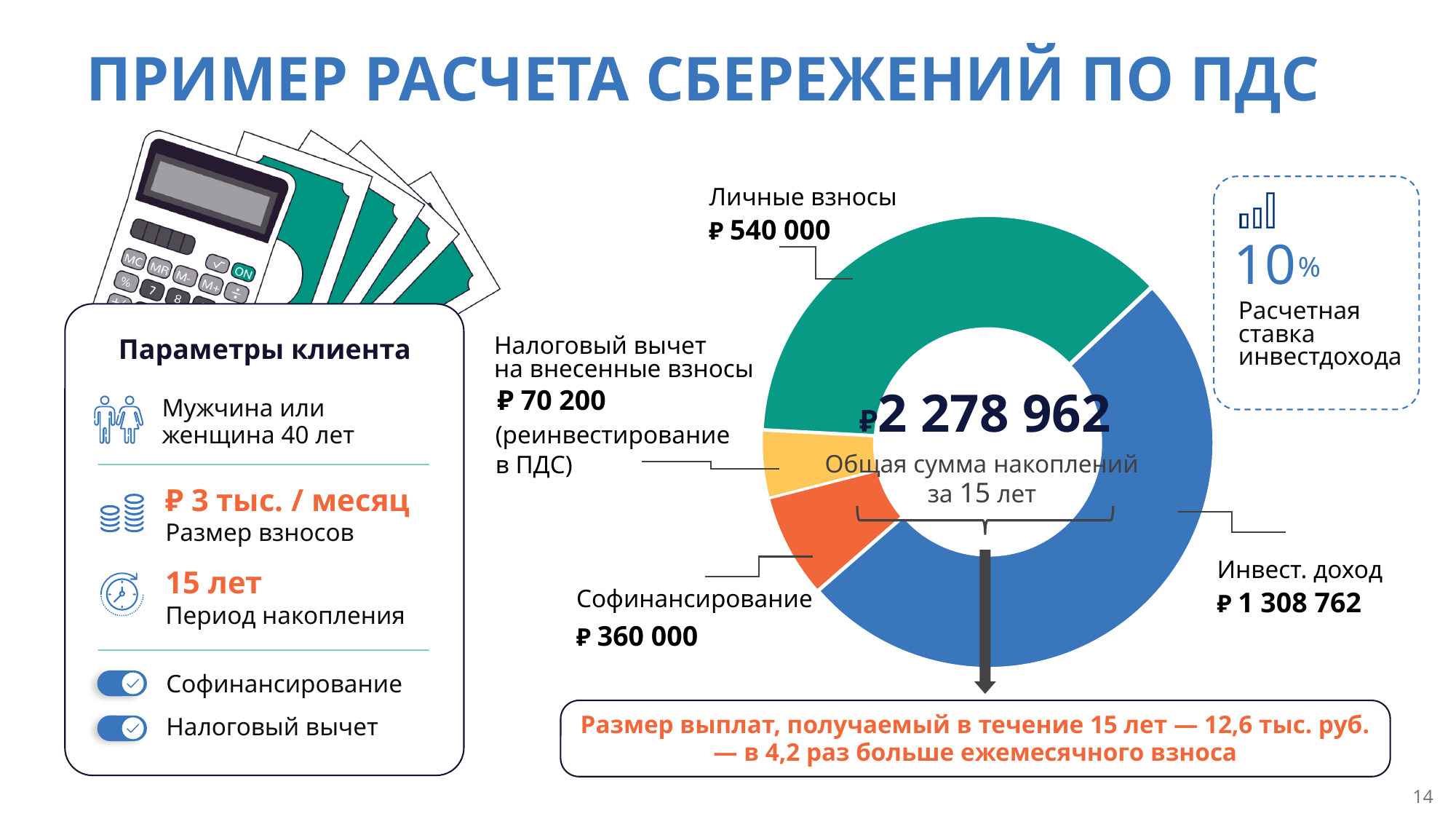
What is the value for Личные взносы? ₽ 540 000 What is the difference between Инвест. доход and Личные взносы? ₽ 768 762 What type of chart is shown on the slide? Pie chart (donut) How many segments does the donut chart have? 4 What is the value for Инвест. доход? ₽ 1 308 762 Which segment of the donut chart is the largest? Инвест. доход What is the value for Налоговый вычет на внесенные взносы? ₽ 70 200 What colour is the Инвест. доход segment of the donut chart? Blue What is the value for Софинансирование? ₽ 360 000 Which is larger: Личные взносы or Софинансирование? Личные взносы What is the total sum shown in the centre of the donut chart (Общая сумма накоплений за 15 лет)? ₽2 278 962 Which segment of the donut chart is the smallest? Налоговый вычет на внесенные взносы